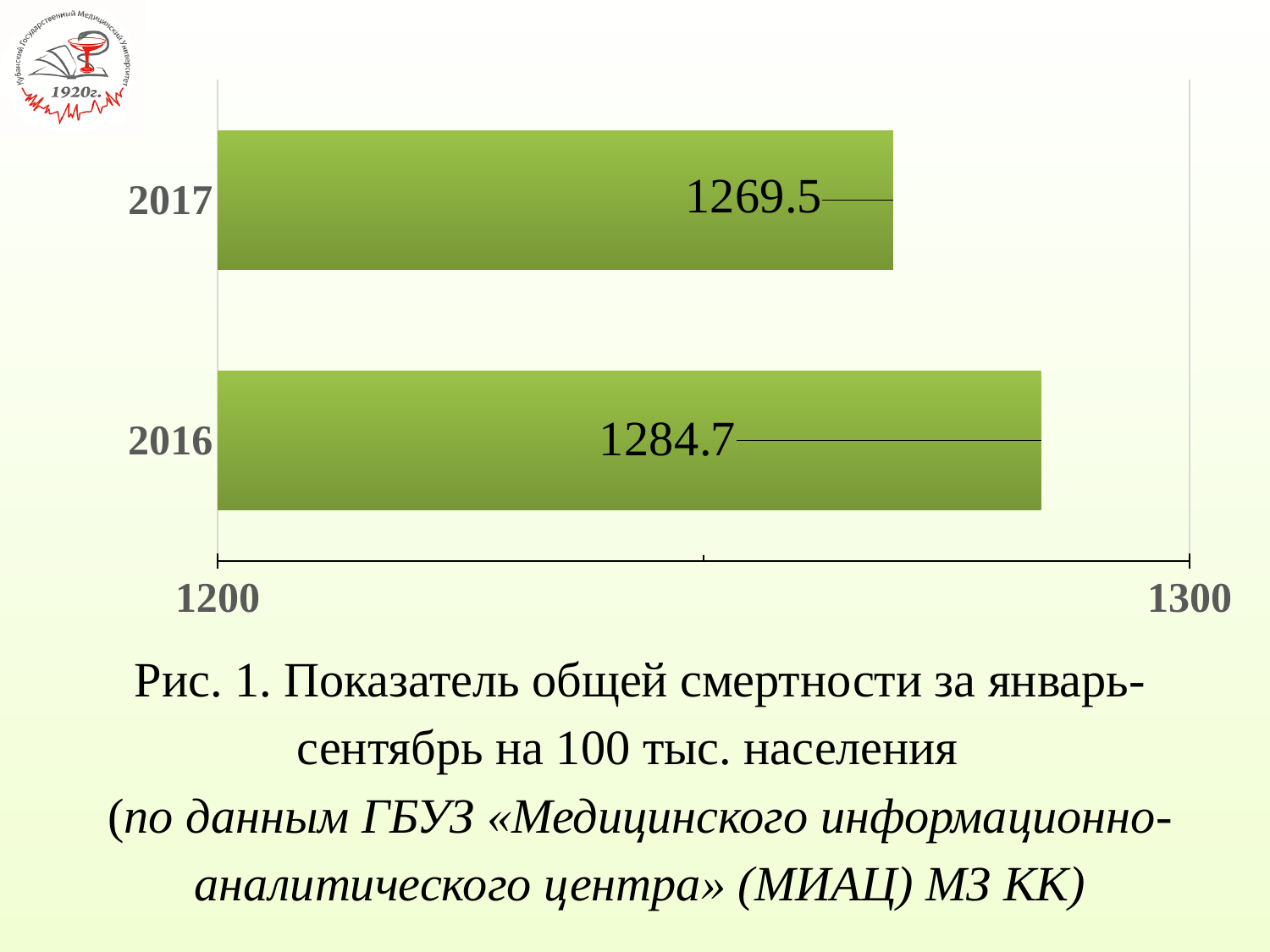
What is the value shown for 2016? 1284.7 Did the mortality indicator rise or fall from 2016 to 2017? fall Is the value for 2016 greater or less than 1250? greater What is the minimum value shown on the horizontal axis? 1200 Is the value for 2017 greater or less than 1300? less What is the value shown for 2017? 1269.5 What is the difference between the values for 2016 and 2017? 15.2 Is the value for 2017 larger or smaller than the value for 2016? smaller What kind of chart is shown on the slide? bar chart Which year has the higher value? 2016 Which year has the lower value? 2017 How many years (categories) are shown in the chart? 2